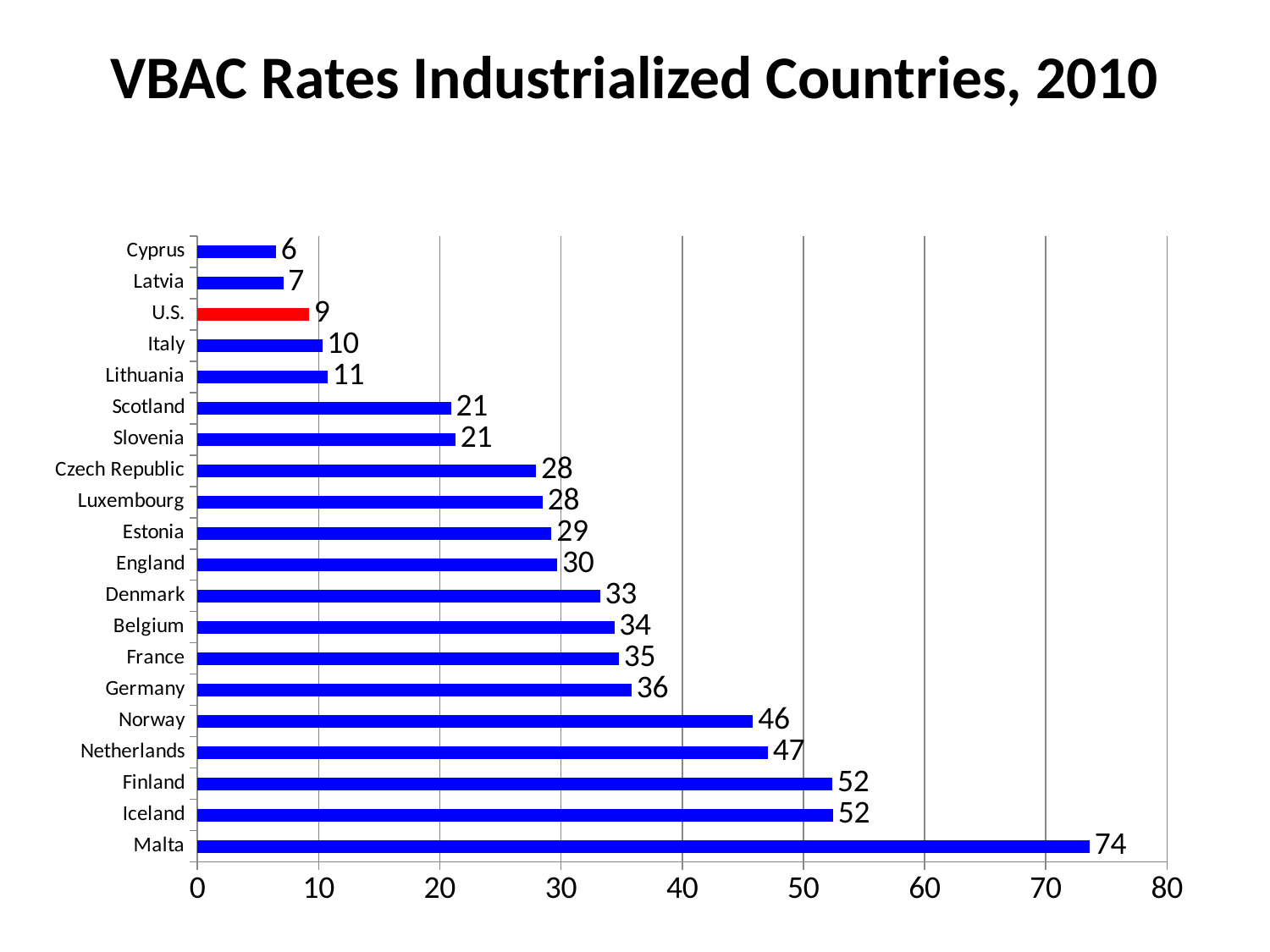
Which country has the lowest VBAC rate on the chart? Cyprus What is the value shown for Norway? 46 Which has a higher value, Denmark or Scotland? Denmark What is the value shown for Czech Republic? 28 Which country has the highest VBAC rate on the chart? Malta Which country's bar is coloured red instead of blue? U.S. What is the difference between the values for Malta and the U.S.? 65 What is the difference between the values for Netherlands and Germany? 11 How many countries are shown on the chart? 20 What is the VBAC rate shown for the U.S.? 9 What kind of chart is this? Bar chart What is the title of the chart? VBAC Rates Industrialized Countries, 2010